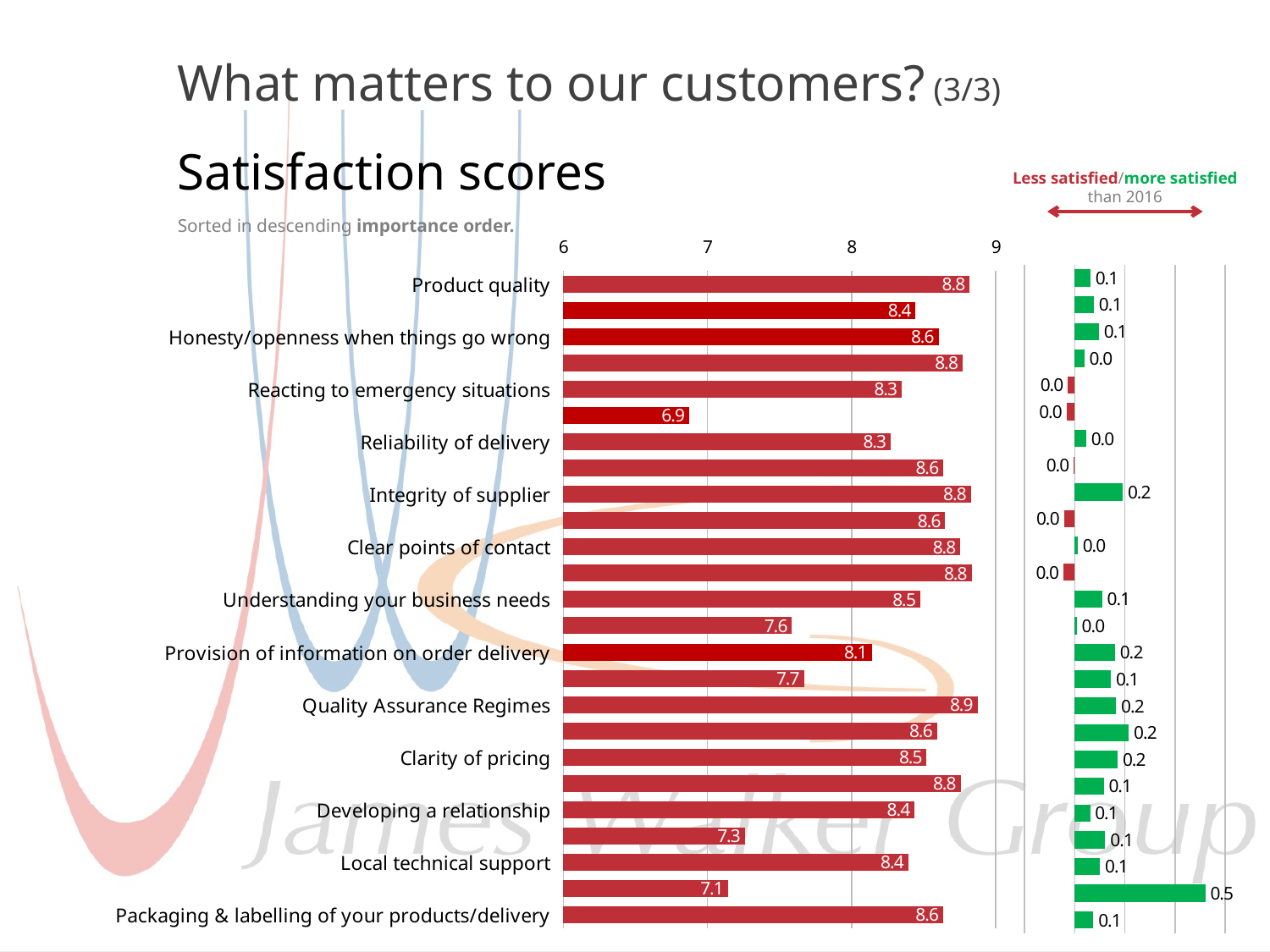
Which has a higher satisfaction score, Product quality or Reacting to emergency situations? Product quality What is the satisfaction score for Provision of information on order delivery? 8.1 In what order are the categories sorted, according to the subtitle? Descending importance order What kind of chart is used to show the satisfaction scores? Bar chart What is the difference between the satisfaction scores for Quality Assurance Regimes and Provision of information on order delivery? 0.8 What is the satisfaction score for Packaging & labelling of your products/delivery? 8.6 What is the satisfaction score for Product quality? 8.8 Which labelled category has the highest satisfaction score? Quality Assurance Regimes Which has a higher satisfaction score, Honesty/openness when things go wrong or Developing a relationship? Honesty/openness when things go wrong How many category labels are listed on the left of the chart? 13 What is the change versus 2016 shown for Integrity of supplier? 0.2 What is the satisfaction score for Reacting to emergency situations? 8.3